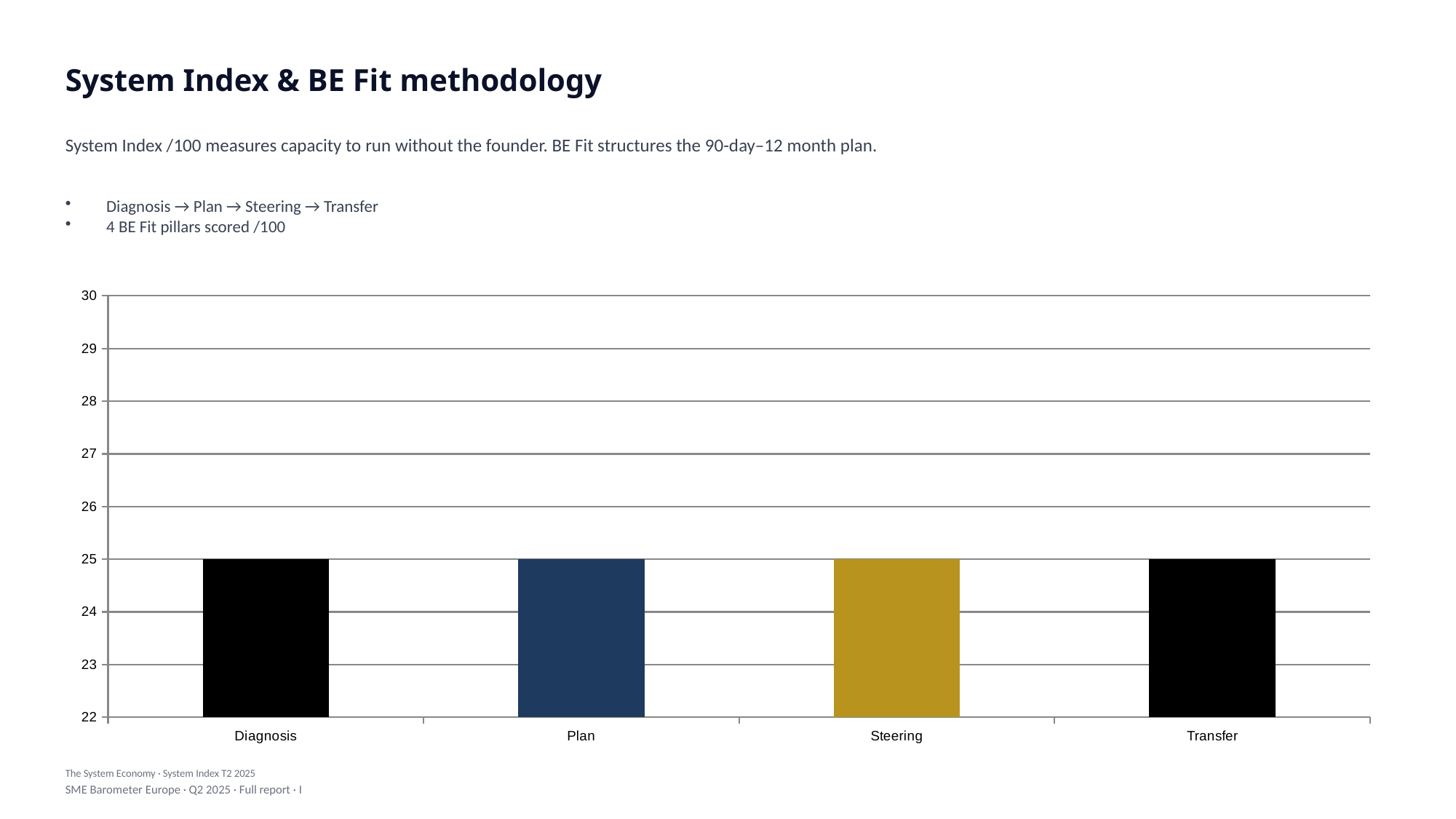
How many categories are shown on the x axis of the chart? 4 Is the value for Transfer greater or less than 26? less What is the value for Steering? 25 Do the values rise, fall, or stay flat from Diagnosis to Transfer along the x axis? stay flat What kind of chart is shown on the slide? bar chart What is the difference between the values for Diagnosis and Transfer? 0 What is the value for Diagnosis? 25 Is the value for Steering greater or less than 24? greater What is the lowest value shown on the vertical axis of the chart? 22 What colour is the bar for Steering? gold What is the value for Transfer? 25 What is the value for Plan? 25